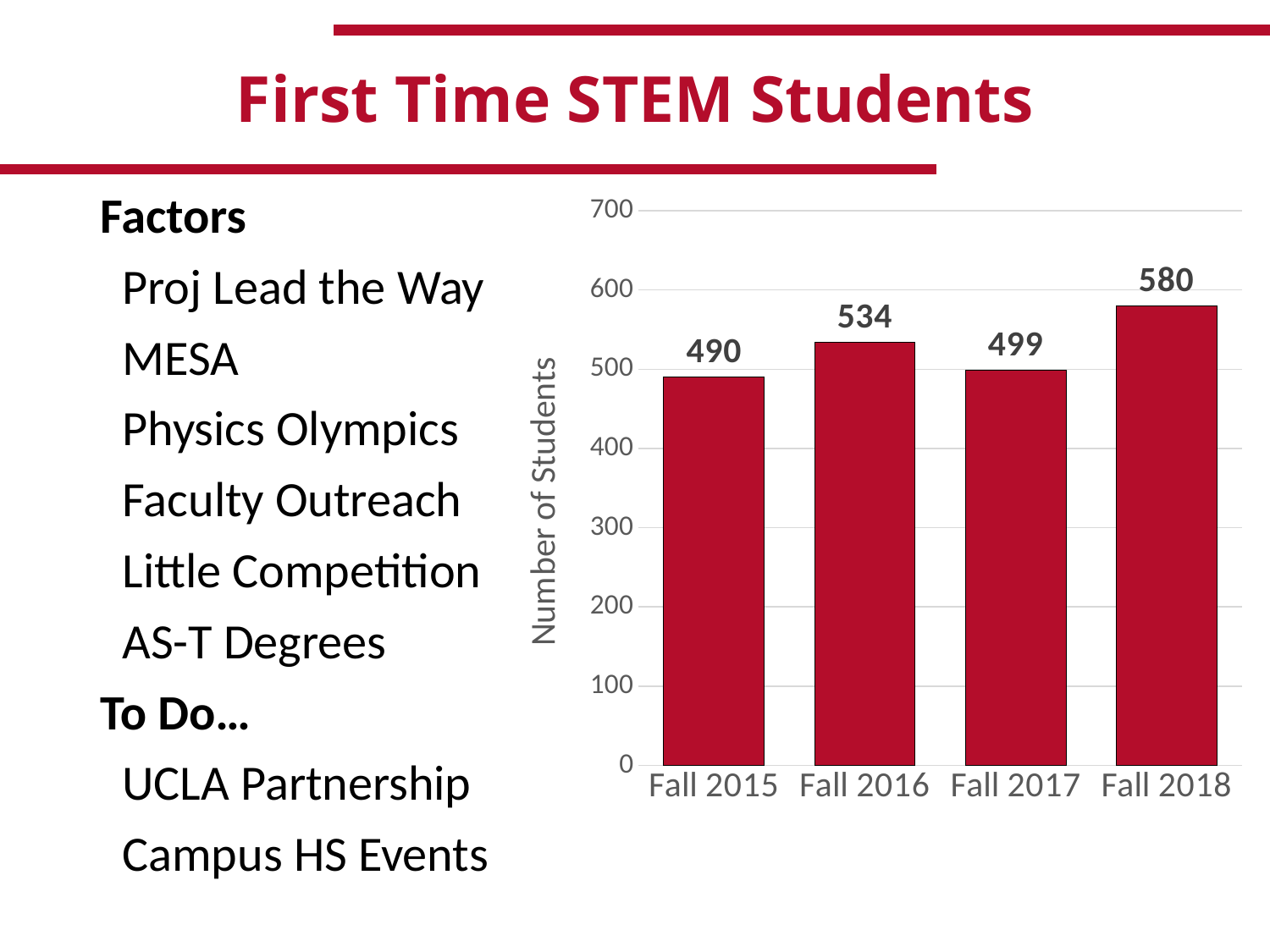
Which term has the highest number of students? Fall 2018 What is the number of students for Fall 2015? 490 What is the difference in number of students between Fall 2018 and Fall 2015? 90 What is the difference in number of students between Fall 2016 and Fall 2017? 35 What is the number of students for Fall 2017? 499 How many terms are shown on the chart? 4 Which term has the lowest number of students? Fall 2015 What kind of chart is shown on the slide? Bar chart What is the number of students for Fall 2018? 580 What is the label on the vertical axis of the chart? Number of Students Which has more students, Fall 2016 or Fall 2017? Fall 2016 Is the value for Fall 2016 greater or less than 500? greater